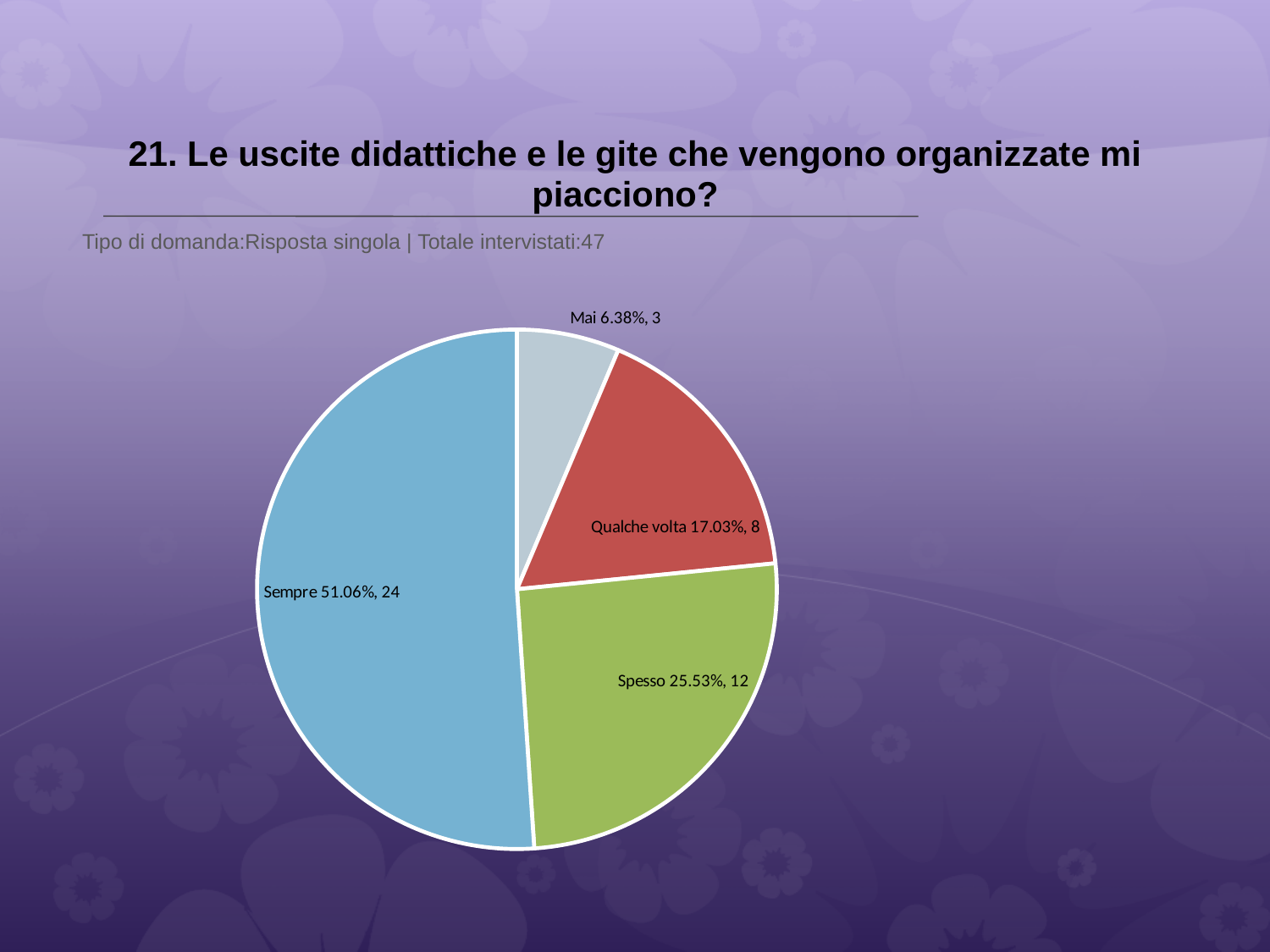
How many respondents answered "Mai"? 3 What colour is the "Sempre" slice? blue What percentage of respondents answered "Qualche volta"? 17.03% What kind of chart is shown on the slide? pie chart Which has more respondents, "Qualche volta" or "Mai"? Qualche volta What is the difference in number of respondents between "Sempre" and "Spesso"? 12 How many respondents answered "Spesso"? 12 Which answer has the smallest share of the pie? Mai How many slices does the pie chart have? 4 What is the total number of respondents shown in the pie chart? 47 Which answer has the largest share of the pie? Sempre What percentage of respondents answered "Sempre"? 51.06%